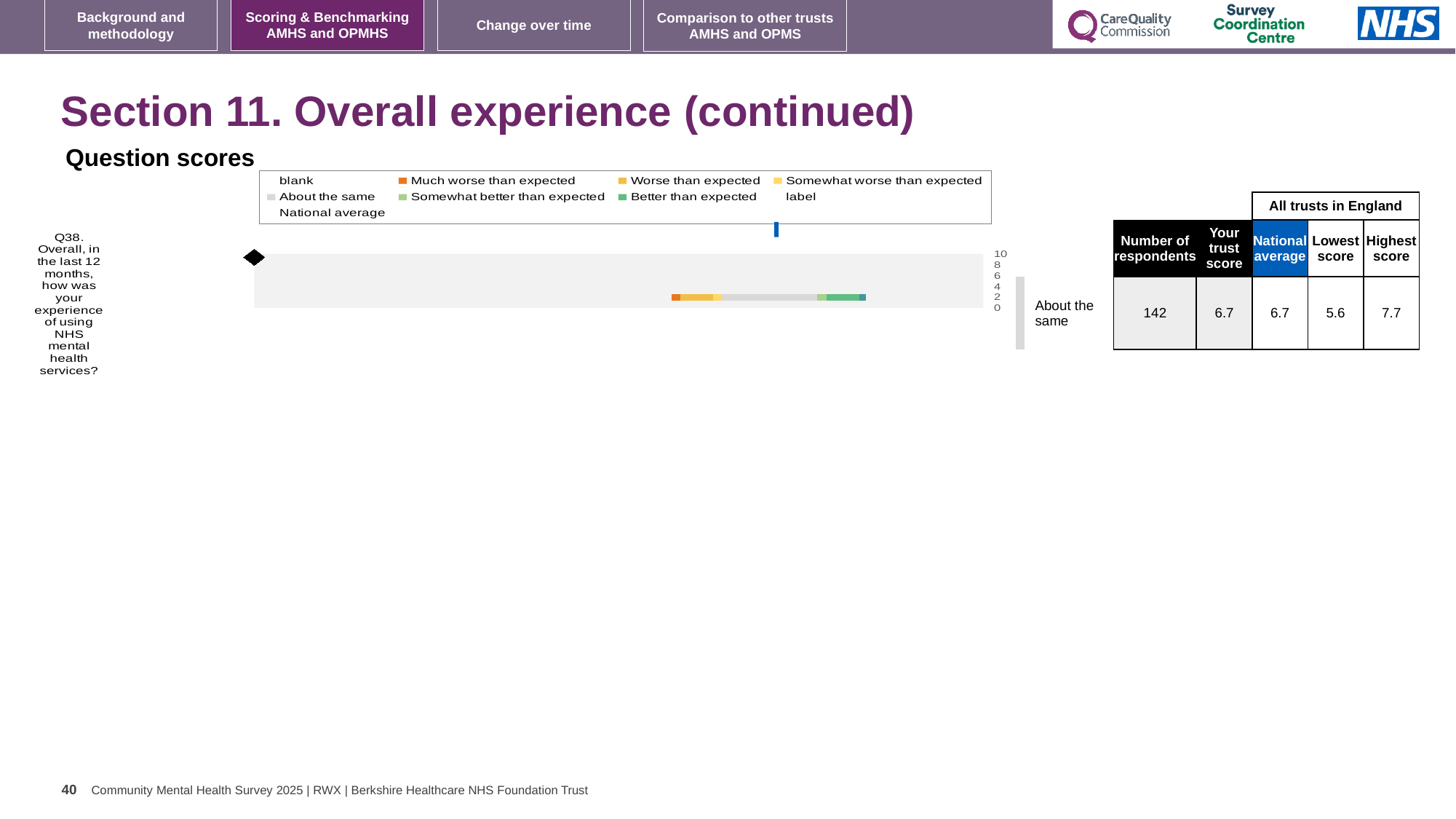
What is the difference between the highest score and the lowest score for Q38? 2.1 What is the trust score for Q38 shown in the table? 6.7 Is the trust score for Q38 higher than, lower than, or the same as the national average? the same What is the difference between the highest score and the trust score for Q38? 1.0 What is the lowest score among all trusts in England for Q38? 5.6 What is the national average score for Q38? 6.7 What kind of chart is used to show the Q38 question score? bar chart What benchmark category label is shown next to the bar for Q38? About the same What is the highest score among all trusts in England for Q38? 7.7 How many survey questions are plotted in the Question scores chart? 1 Which legend entry is marked with an orange square? Much worse than expected How many respondents answered Q38? 142